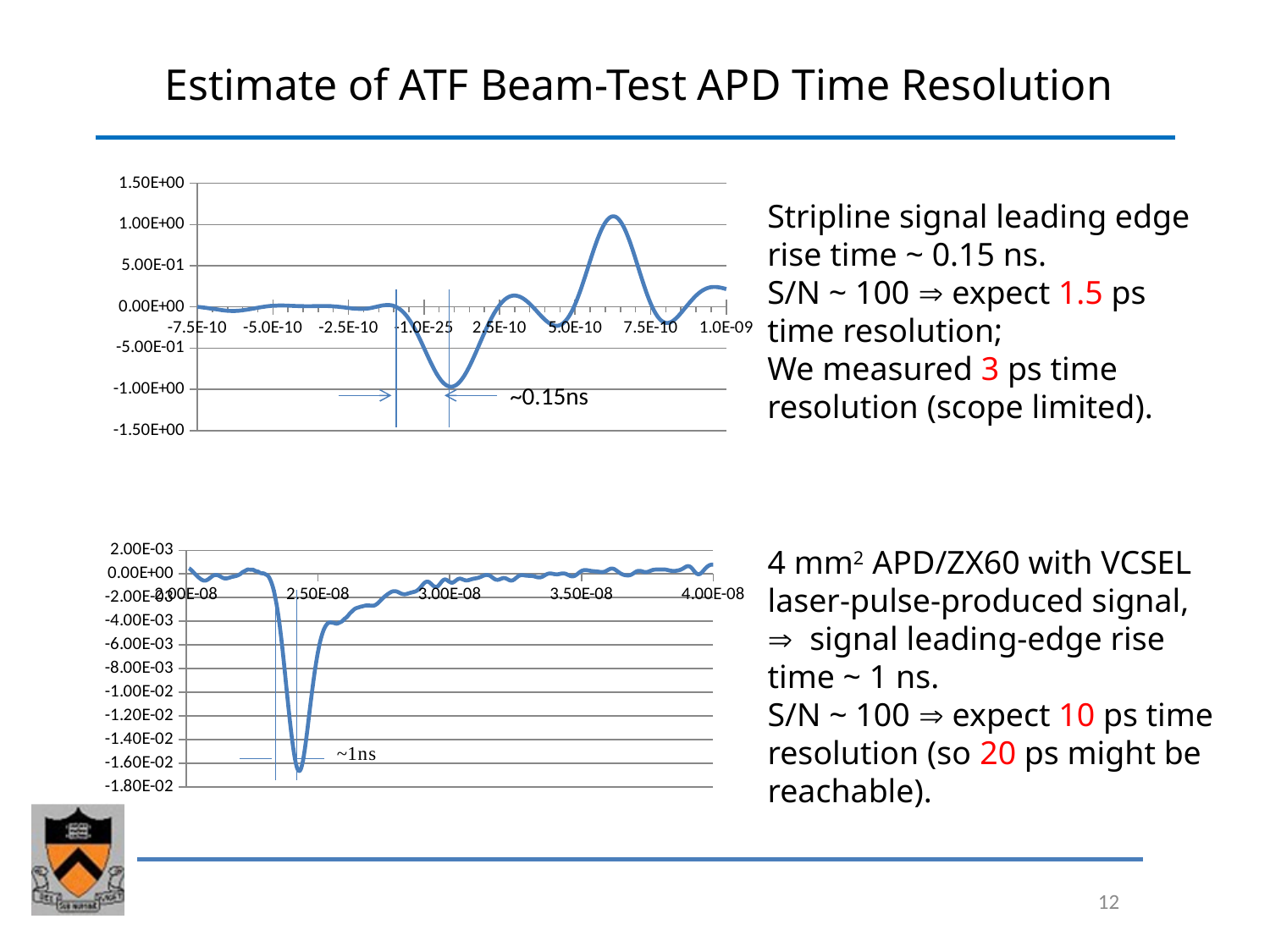
How many x-axis tick labels are shown on the top chart? 8 What rise-time annotation is written next to the dip in the bottom chart? ~1ns What rise-time annotation is written next to the trough in the top chart? ~0.15ns In the top chart, is the highest value of the signal greater or less than 5.00E-01? greater How many x-axis tick labels are shown on the bottom chart? 5 In the bottom chart, is the lowest value of the signal greater or less than -1.40E-02? less What kind of chart is the bottom chart on the slide? line chart In the top chart, which is higher: the peak near 6E-10 or the peak near 1.0E-09? the peak near 6E-10 In the bottom chart, is the value at 3.50E-08 greater or less than -4.00E-03? greater What kind of chart is the top chart on the slide? line chart In the bottom chart, after the minimum near 2.5E-08, do the values rise or fall as x increases? rise